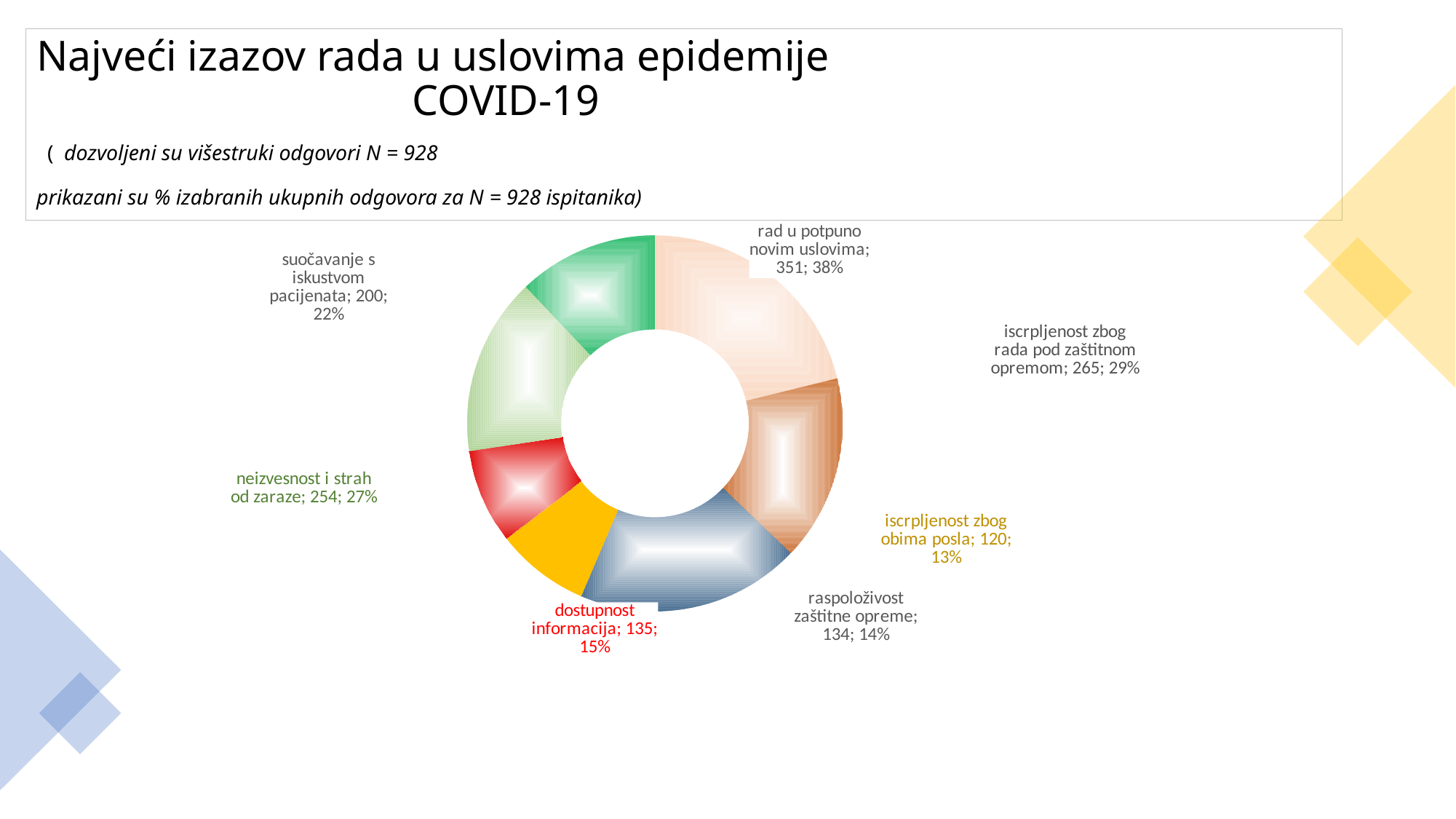
How many responses are shown for "rad u potpuno novim uslovima"? 351 What percentage is shown for "raspoloživost zaštitne opreme"? 14% How many categories are shown in the chart? 7 What percentage is shown for "neizvesnost i strah od zaraze"? 27% What is the difference in responses between "dostupnost informacija" and "raspoloživost zaštitne opreme"? 1 What colour is the slice for "dostupnost informacija"? red How many responses are shown for "suočavanje s iskustvom pacijenata"? 200 What is the difference in responses between "rad u potpuno novim uslovima" and "iscrpljenost zbog rada pod zaštitnom opremom"? 86 Which category has the lowest number of responses? iscrpljenost zbog obima posla Which has more responses: "neizvesnost i strah od zaraze" or "suočavanje s iskustvom pacijenata"? neizvesnost i strah od zaraze What kind of chart is shown on the slide? doughnut (pie) chart Which category has the highest number of responses? rad u potpuno novim uslovima